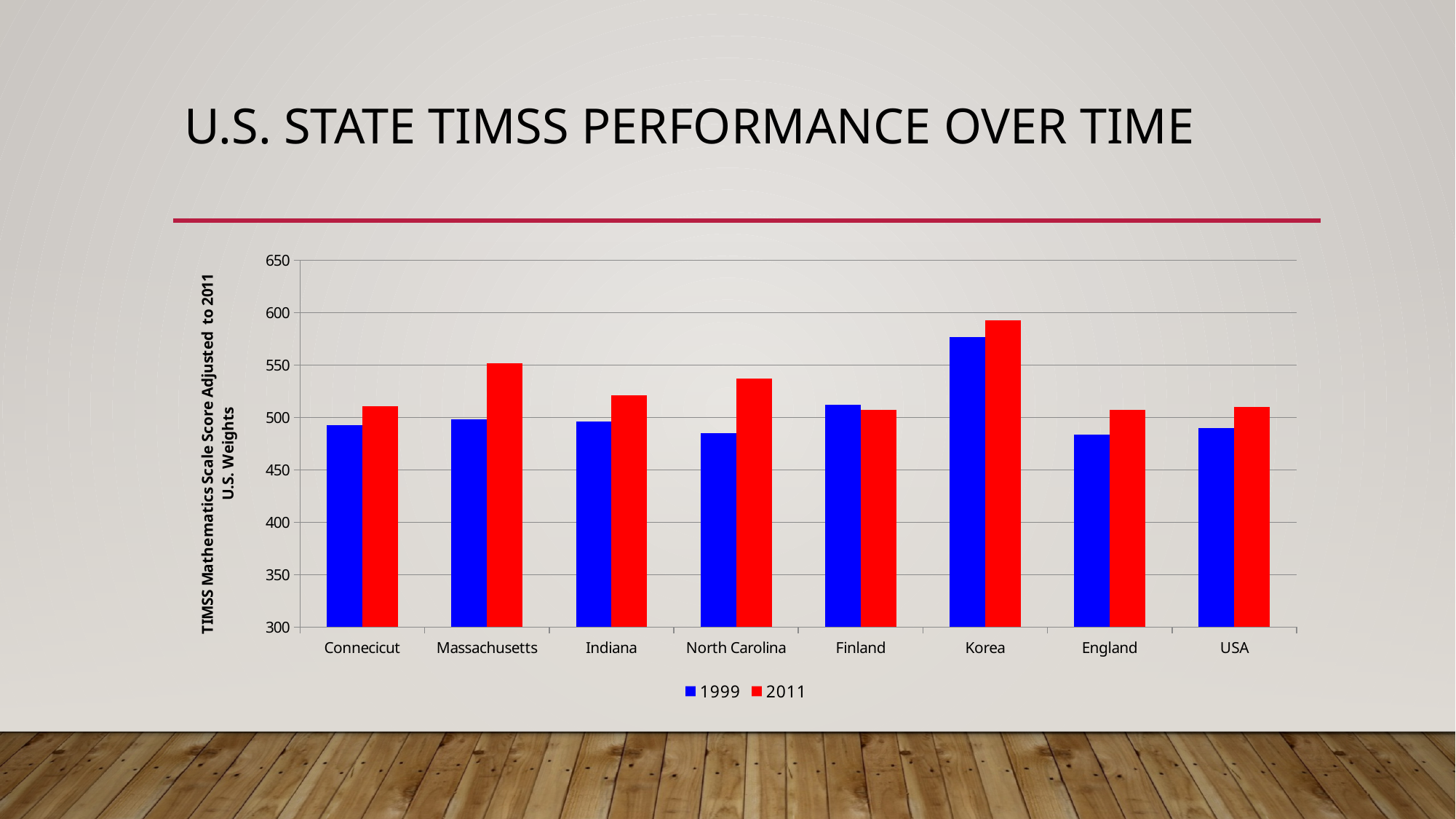
Is the 1999 value for Korea greater or less than 600? less Which is larger: the 2011 value for Massachusetts or the 2011 value for Connecicut? Massachusetts Which is larger: the 1999 value for Korea or the 1999 value for Finland? Korea Is the 2011 value for Indiana greater or less than 500? greater What kind of chart is shown on the slide? bar chart Which category has the highest value for the 2011 series? Korea Which category has the highest value for the 1999 series? Korea Is the 2011 value for Korea greater or less than 550? greater How many series does the legend list? 2 How many categories are shown on the x axis of the chart? 8